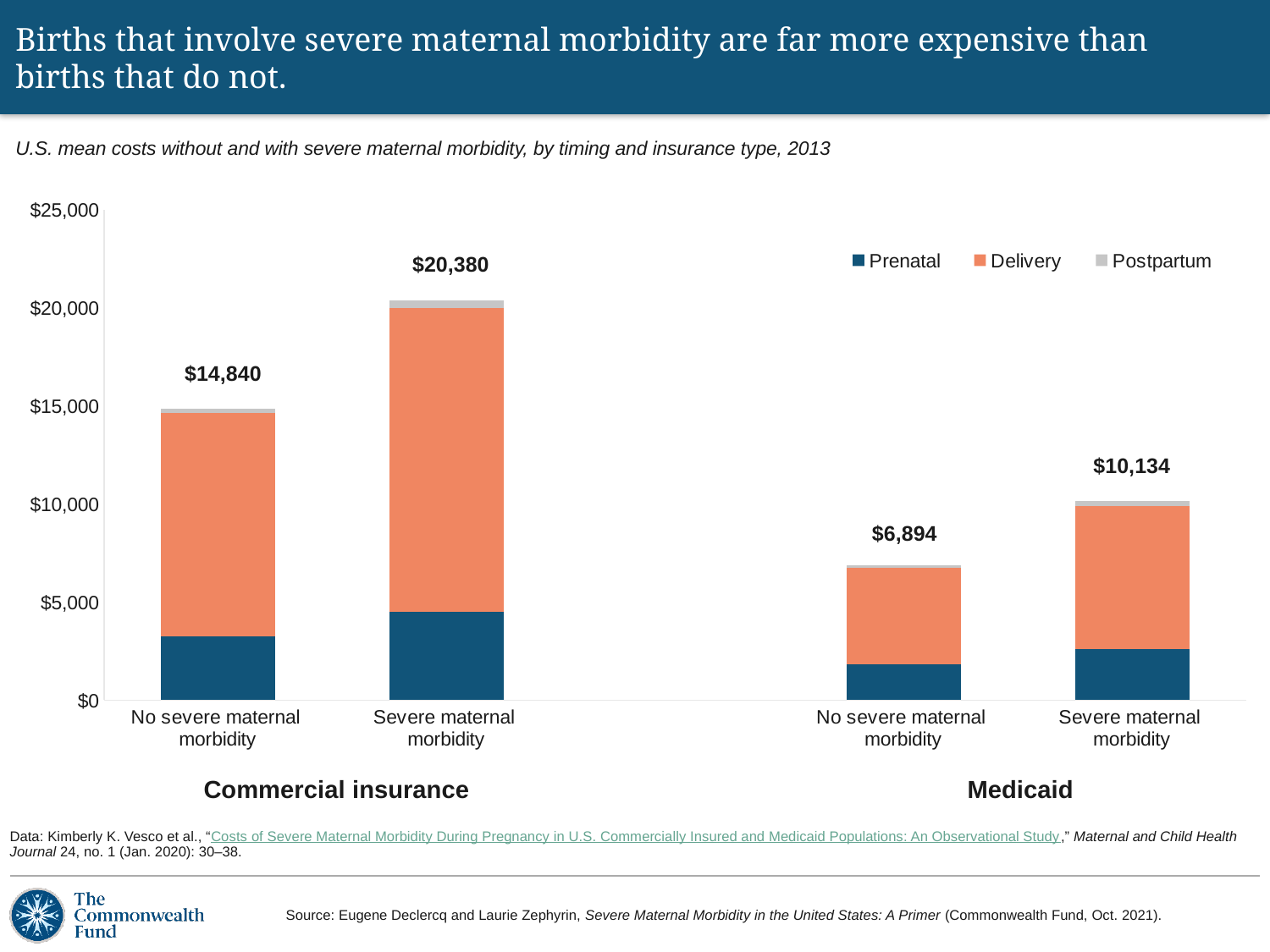
Which cost component is shown in orange in the legend? Delivery What is the total mean cost for births with no severe maternal morbidity under Medicaid? $6,894 How many series does the legend list? 3 Which is larger: the total cost for no severe maternal morbidity under commercial insurance or for severe maternal morbidity under Medicaid? No severe maternal morbidity under commercial insurance What is the total mean cost for births with severe maternal morbidity under Medicaid? $10,134 What is the difference in total mean cost between births with and without severe maternal morbidity under Medicaid? $3,240 Which bar has the lowest total mean cost? No severe maternal morbidity, Medicaid What is the total mean cost for births with severe maternal morbidity under commercial insurance? $20,380 What kind of chart is shown on the slide? Stacked bar chart What is the difference in total mean cost between births with and without severe maternal morbidity under commercial insurance? $5,540 Is the Prenatal segment for severe maternal morbidity under commercial insurance greater or less than $5,000? less Which bar has the highest total mean cost? Severe maternal morbidity, Commercial insurance